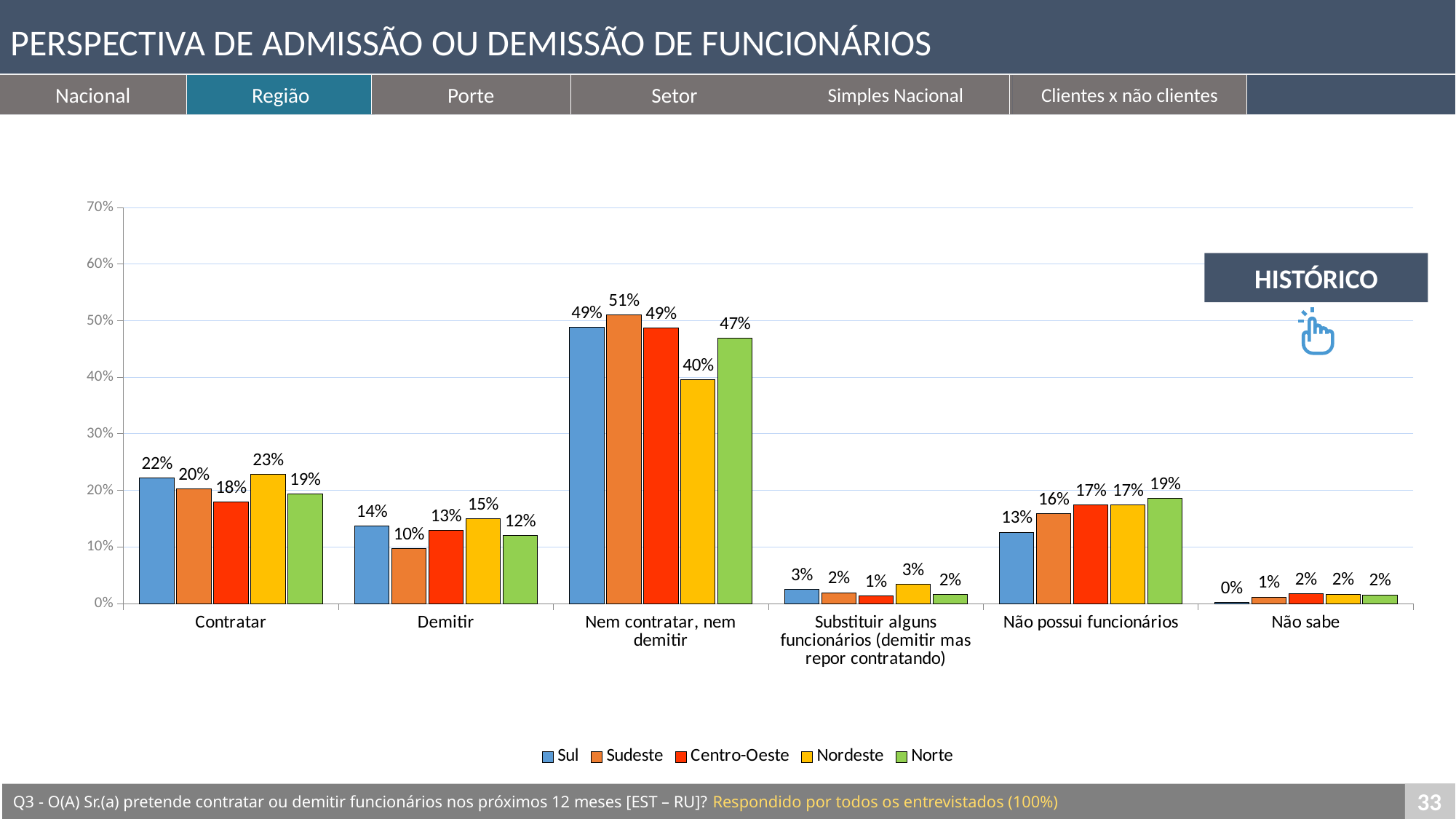
Which region is represented by the red bars in the legend? Centro-Oeste What is the value for Nordeste in the 'Contratar' category? 23% Is the value for Norte in the 'Nem contratar, nem demitir' category greater or less than 40%? greater What is the value for Norte in the 'Não possui funcionários' category? 19% What kind of chart is shown on the slide? Bar chart What is the value for Sudeste in the 'Nem contratar, nem demitir' category? 51% How many series does the legend list? 5 What is the difference between the Sudeste and Nordeste values in the 'Nem contratar, nem demitir' category? 11 percentage points How many categories are shown on the x axis? 6 Which region has the highest value in the 'Demitir' category? Nordeste Which region has the lowest value in the 'Nem contratar, nem demitir' category? Nordeste In the 'Demitir' category, which is larger: the value for Sul or the value for Sudeste? Sul